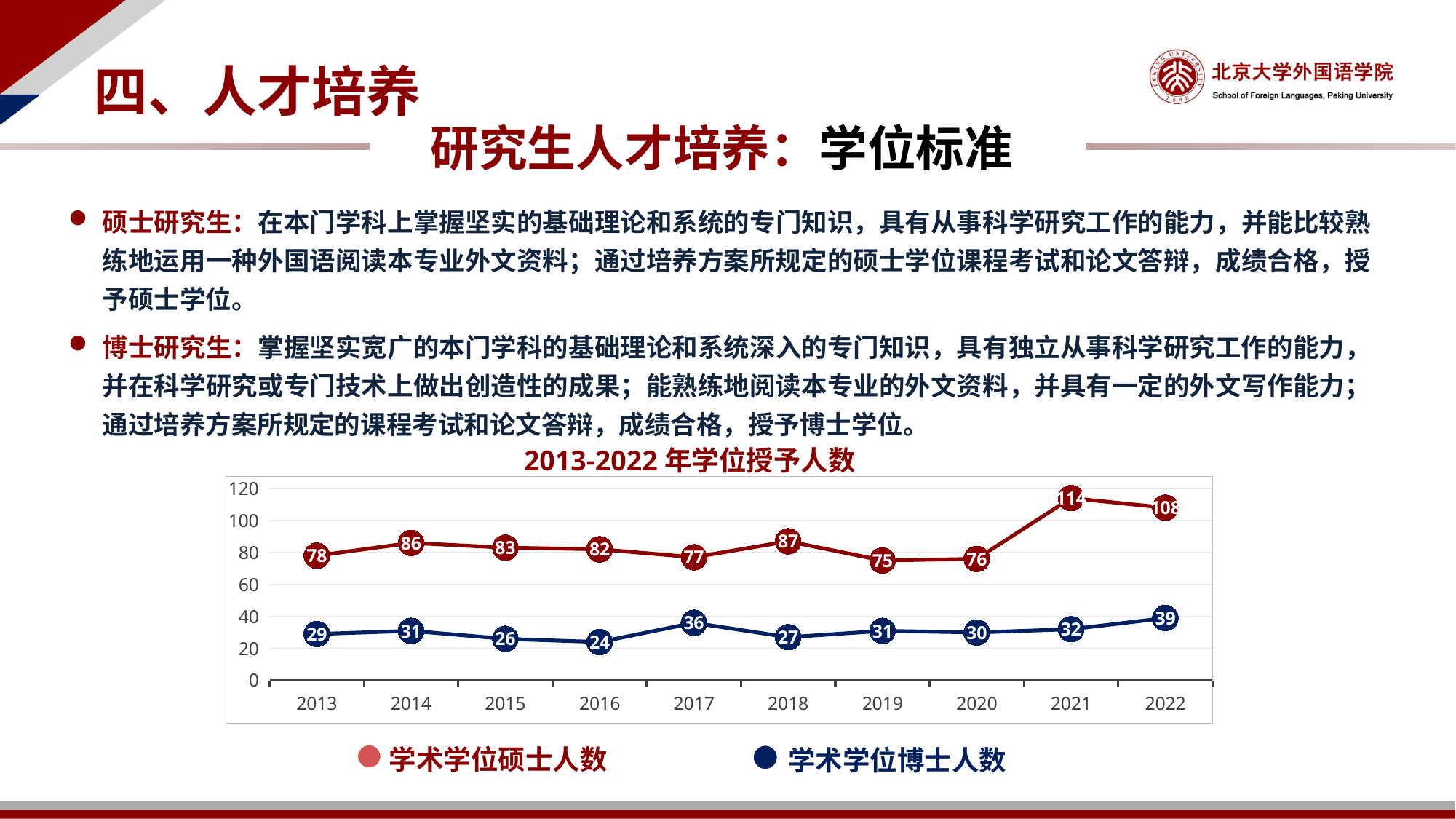
How many years are shown on the x axis? 10 How many series does the legend list? 2 What is the value for 学术学位博士人数 in 2016? 24 What type of chart is shown on the slide? Line chart Does 学术学位硕士人数 rise or fall from 2020 to 2021? Rise In which year is 学术学位硕士人数 lowest? 2019 In which year is 学术学位博士人数 highest? 2022 What is the value for 学术学位硕士人数 in 2019? 75 What is the title of the chart? 2013-2022 年学位授予人数 What is the value for 学术学位硕士人数 in 2021? 114 Which is larger: 学术学位博士人数 in 2017 or in 2018? 2017 What is the difference between 学术学位硕士人数 in 2021 and in 2020? 38